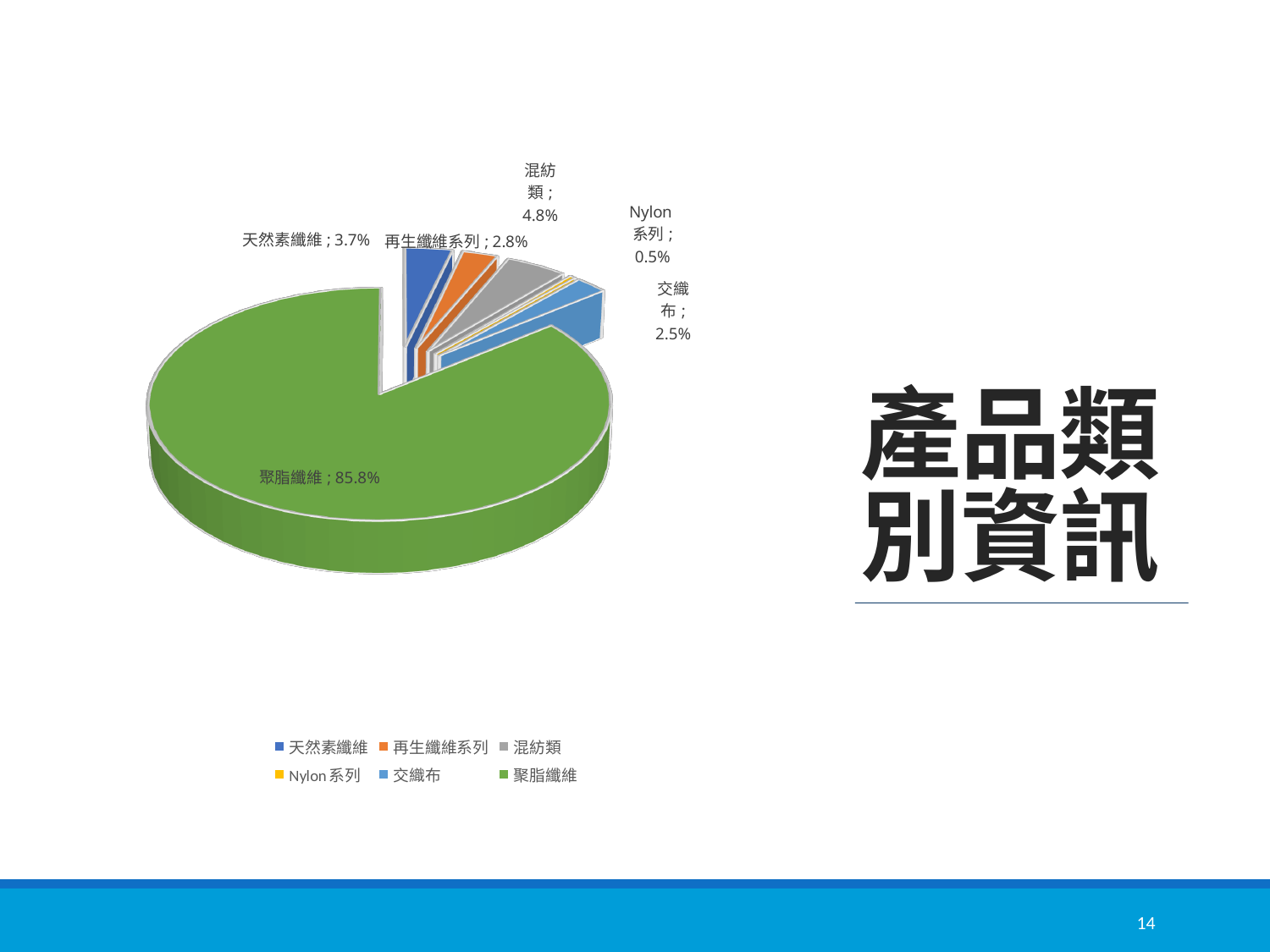
What share of the pie does 聚脂纖維 hold? 85.8% What is the value shown for 天然素纖維? 3.7% What colour is the 聚脂纖維 slice in the pie chart? Green What is the value shown for 交織布? 2.5% How many categories are shown in the pie chart? 6 Which category has the largest slice of the pie? 聚脂纖維 What kind of chart is shown on the slide? Pie chart What is the value shown for Nylon 系列? 0.5% Which is larger, the share of 天然素纖維 or the share of 交織布? 天然素纖維 What is the value shown for 混紡類? 4.8% Which category has the smallest slice of the pie? Nylon 系列 What is the difference between the shares of 混紡類 and 再生纖維系列? 2.0%